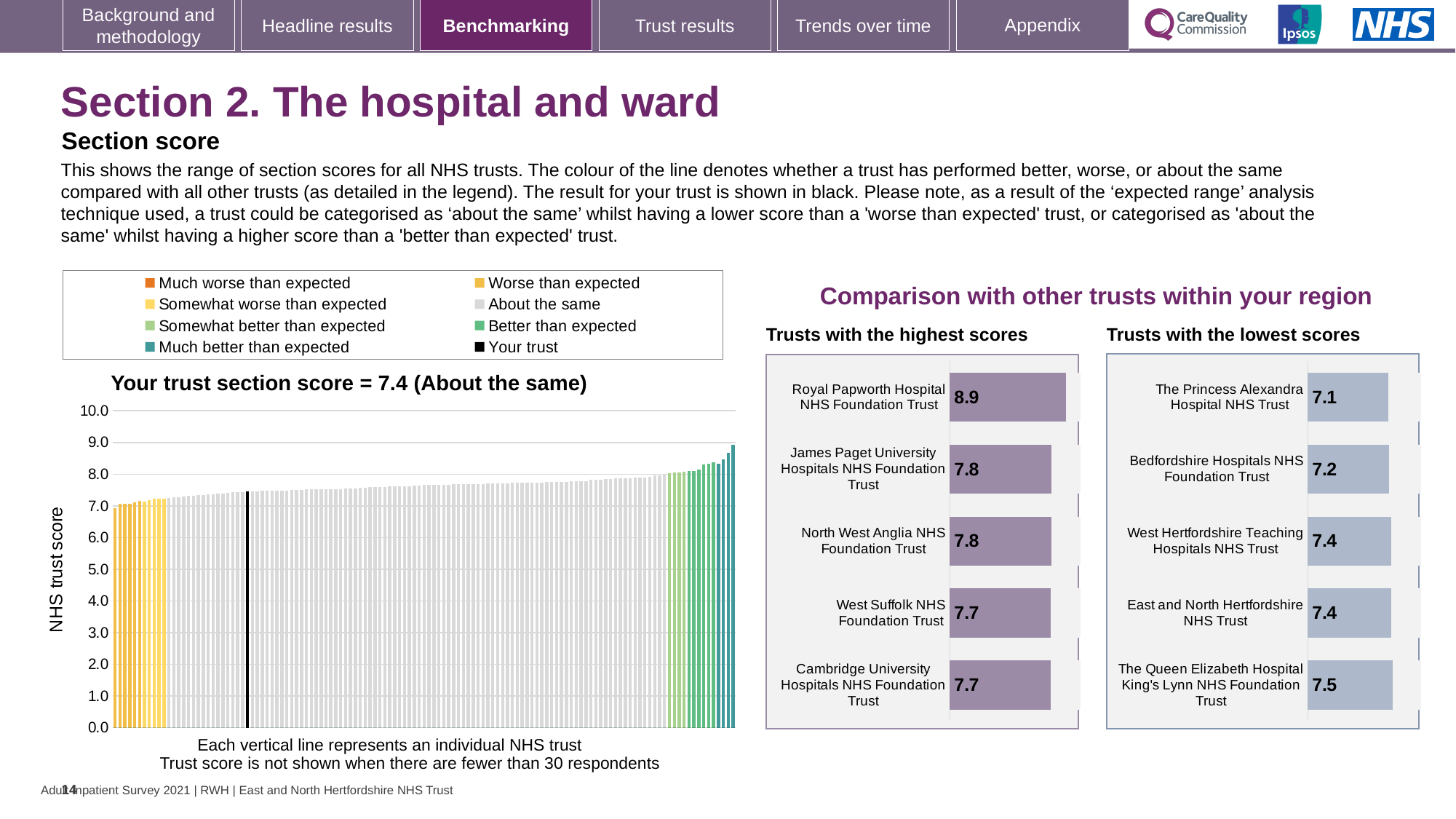
In the 'Trusts with the lowest scores' chart, which has the larger score: Bedfordshire Hospitals NHS Foundation Trust or The Queen Elizabeth Hospital King's Lynn NHS Foundation Trust? The Queen Elizabeth Hospital King's Lynn NHS Foundation Trust In the 'Trusts with the lowest scores' chart, which trust has the lowest score? The Princess Alexandra Hospital NHS Trust In the 'Trusts with the lowest scores' chart, which trust has the highest score? The Queen Elizabeth Hospital King's Lynn NHS Foundation Trust How many entries does the legend above the main chart on the left list? 8 In the main chart on the left, what is your trust's section score? 7.4 In the 'Trusts with the lowest scores' chart, what is the difference between the scores of The Queen Elizabeth Hospital King's Lynn NHS Foundation Trust and The Princess Alexandra Hospital NHS Trust? 0.4 In the 'Trusts with the lowest scores' chart, what is the score for Bedfordshire Hospitals NHS Foundation Trust? 7.2 In the 'Trusts with the highest scores' chart, what is the difference between the scores of Royal Papworth Hospital NHS Foundation Trust and West Suffolk NHS Foundation Trust? 1.2 In the main chart on the left, do the trust scores rise or fall from left to right along the x axis? rise In the 'Trusts with the highest scores' chart, which trust has the highest score? Royal Papworth Hospital NHS Foundation Trust How many trusts are shown in the 'Trusts with the highest scores' chart? 5 In the 'Trusts with the highest scores' chart, what is the score for Royal Papworth Hospital NHS Foundation Trust? 8.9